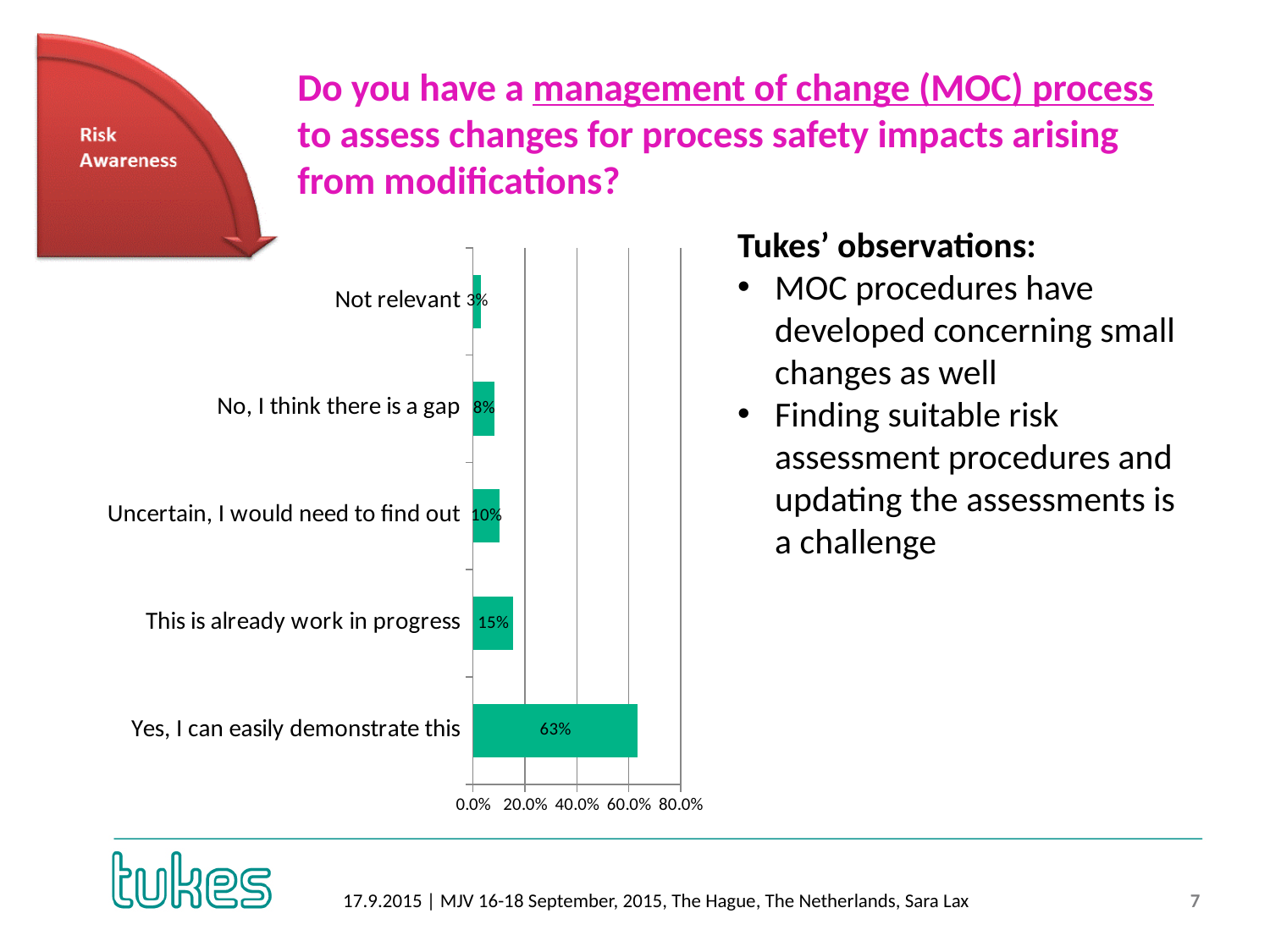
Which response category has the highest value? Yes, I can easily demonstrate this What is the value for "Not relevant"? 3% Is the value for "Yes, I can easily demonstrate this" greater or less than 40.0%? greater What is the value for "This is already work in progress"? 15% What percentage of respondents answered "Yes, I can easily demonstrate this"? 63% What is the value for "No, I think there is a gap"? 8% How many response categories are shown in the chart? 5 What is the value for "Uncertain, I would need to find out"? 10% Which response category has the lowest value? Not relevant What is the difference between the values for "Yes, I can easily demonstrate this" and "This is already work in progress"? 48% What type of chart is shown on the slide? Bar chart Which is larger, the value for "Uncertain, I would need to find out" or the value for "No, I think there is a gap"? Uncertain, I would need to find out